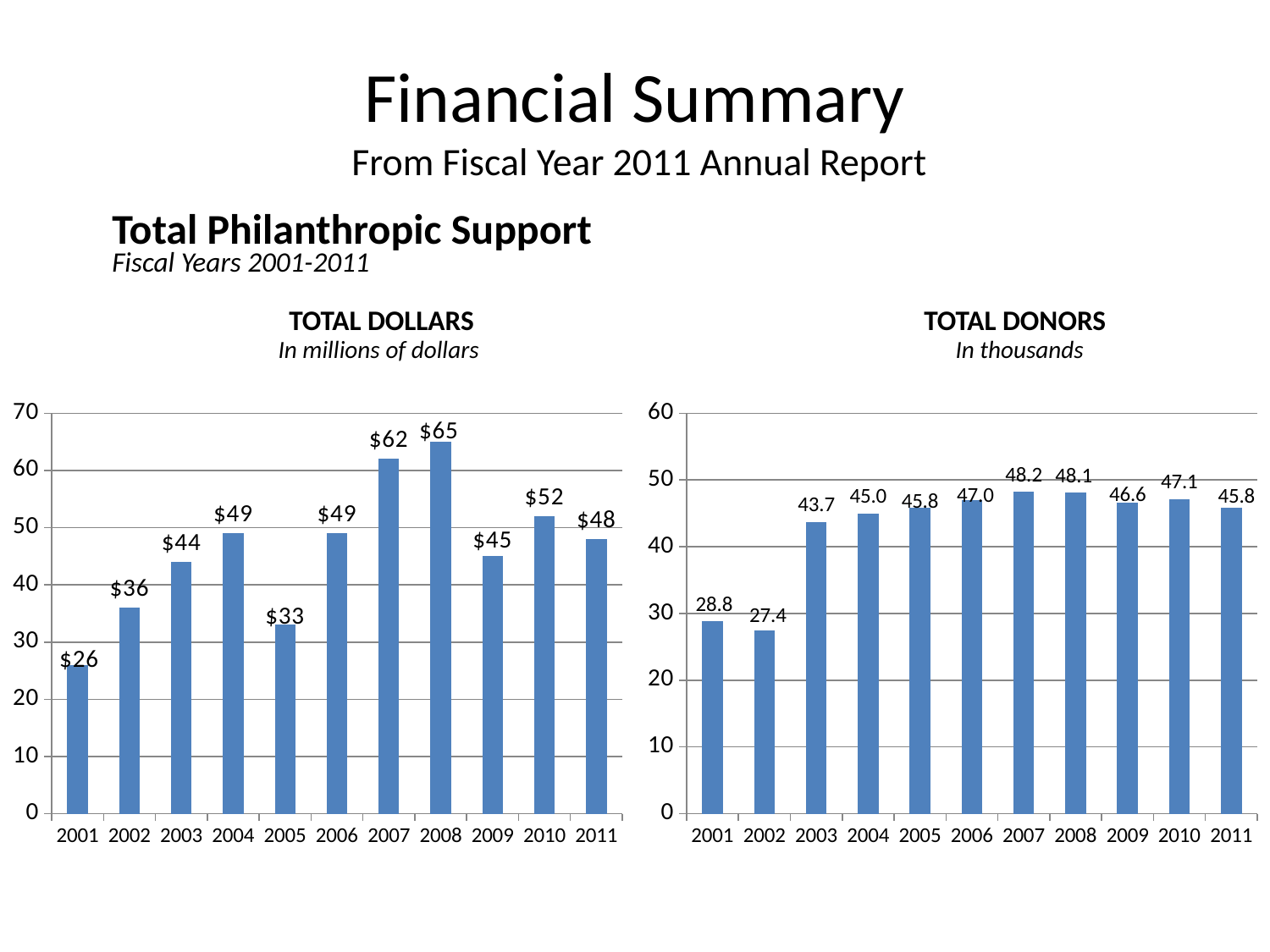
In the TOTAL DOLLARS chart, which year has the lowest value? 2001 In the TOTAL DONORS chart, which year has the lowest value? 2002 In the TOTAL DOLLARS chart, what is the difference between the values for 2008 and 2009? $20 In the TOTAL DOLLARS chart, what is the value for 2011? $48 In the TOTAL DOLLARS chart, what is the value for 2008? $65 In the TOTAL DOLLARS chart, which is larger, the value for 2005 or the value for 2006? 2006 In the TOTAL DONORS chart, what is the value for 2007? 48.2 In the TOTAL DONORS chart, what is the difference between the values for 2001 and 2002? 1.4 In the TOTAL DOLLARS chart, which year has the highest value? 2008 In the TOTAL DONORS chart, which is larger, the value for 2003 or the value for 2010? 2010 What kind of chart is the TOTAL DONORS chart? Bar chart How many years are shown in the TOTAL DOLLARS chart? 11